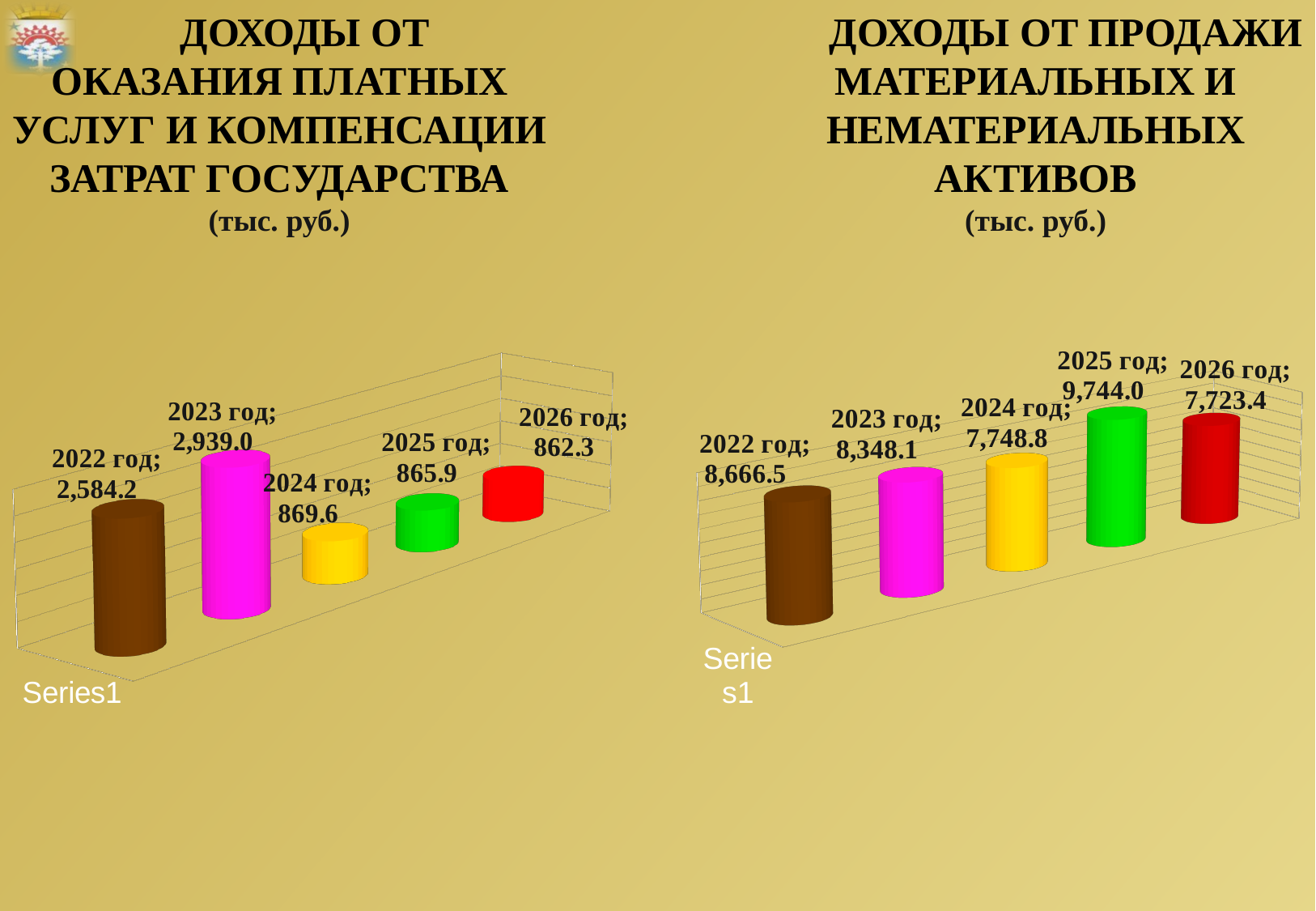
In the right chart (ДОХОДЫ ОТ ПРОДАЖИ МАТЕРИАЛЬНЫХ И НЕМАТЕРИАЛЬНЫХ АКТИВОВ), what is the value for 2025 год? 9,744.0 In the right chart (ДОХОДЫ ОТ ПРОДАЖИ МАТЕРИАЛЬНЫХ И НЕМАТЕРИАЛЬНЫХ АКТИВОВ), what is the value for 2022 год? 8,666.5 In the left chart (ДОХОДЫ ОТ ОКАЗАНИЯ ПЛАТНЫХ УСЛУГ), what is the value for 2026 год? 862.3 In the right chart (ДОХОДЫ ОТ ПРОДАЖИ МАТЕРИАЛЬНЫХ И НЕМАТЕРИАЛЬНЫХ АКТИВОВ), which year has the highest value? 2025 год In the left chart (ДОХОДЫ ОТ ОКАЗАНИЯ ПЛАТНЫХ УСЛУГ), which year has the lowest value? 2026 год In the left chart (ДОХОДЫ ОТ ОКАЗАНИЯ ПЛАТНЫХ УСЛУГ), what is the difference between the values for 2023 год and 2022 год? 354.8 In the right chart (ДОХОДЫ ОТ ПРОДАЖИ МАТЕРИАЛЬНЫХ И НЕМАТЕРИАЛЬНЫХ АКТИВОВ), which is larger: the value for 2022 год or 2023 год? 2022 год In the left chart (ДОХОДЫ ОТ ОКАЗАНИЯ ПЛАТНЫХ УСЛУГ), what is the value for 2023 год? 2,939.0 In the left chart (ДОХОДЫ ОТ ОКАЗАНИЯ ПЛАТНЫХ УСЛУГ), which year has the highest value? 2023 год In the right chart (ДОХОДЫ ОТ ПРОДАЖИ МАТЕРИАЛЬНЫХ И НЕМАТЕРИАЛЬНЫХ АКТИВОВ), what is the difference between the values for 2025 год and 2026 год? 2,020.6 In the left chart (ДОХОДЫ ОТ ОКАЗАНИЯ ПЛАТНЫХ УСЛУГ), how many years are shown? 5 In the right chart (ДОХОДЫ ОТ ПРОДАЖИ МАТЕРИАЛЬНЫХ И НЕМАТЕРИАЛЬНЫХ АКТИВОВ), which year has the lowest value? 2026 год